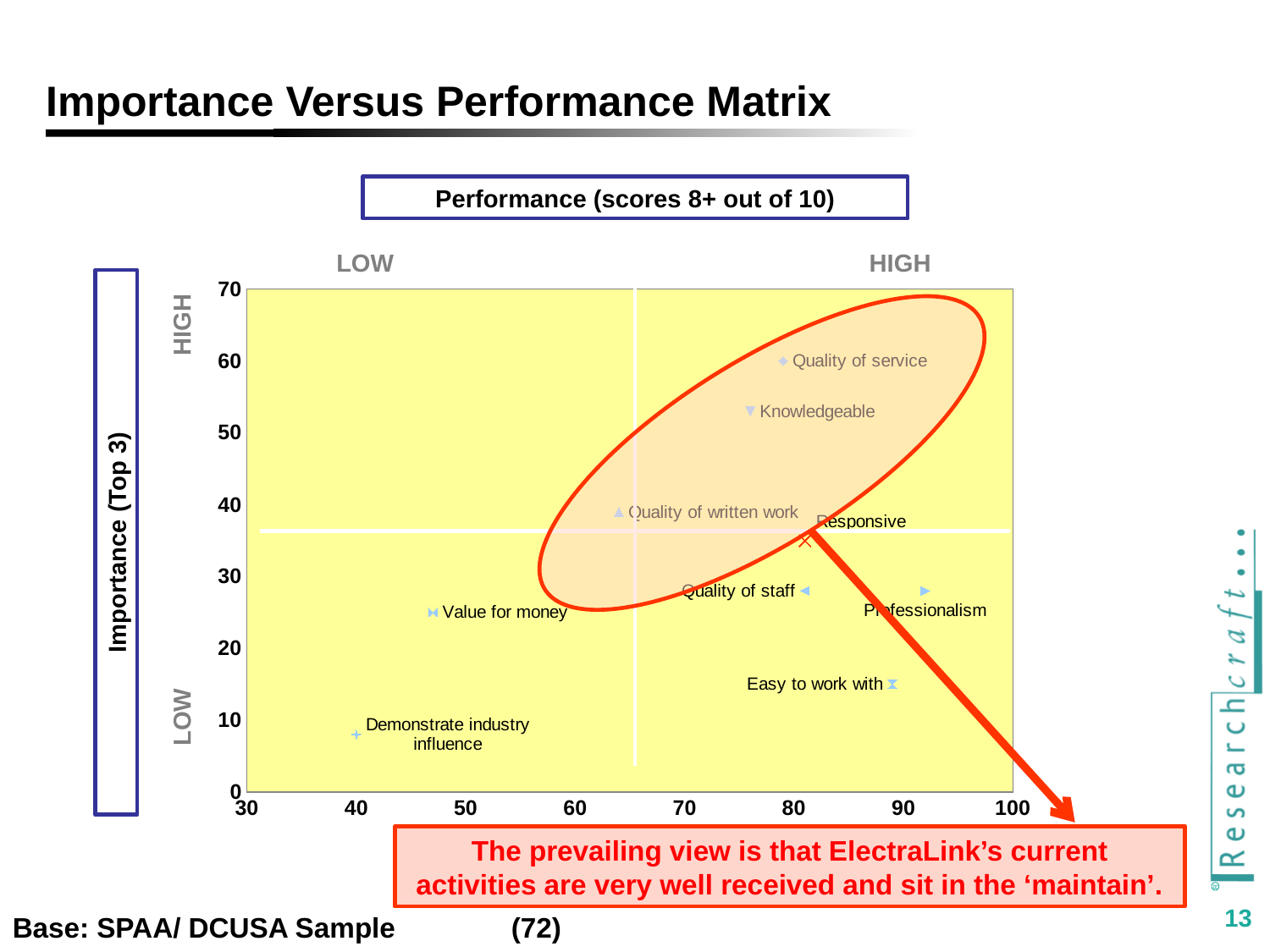
Is the importance value for Demonstrate industry influence greater or less than 20? less How many attributes are plotted as points on the matrix? 9 Is the performance value for Professionalism greater or less than 80? greater What is the title of the chart on the slide? Importance Versus Performance Matrix Which attribute has the lowest importance score on the matrix? Demonstrate industry influence What kind of chart is shown on the slide? Scatter chart Is the importance value for Quality of service greater or less than 50? greater Which attribute has the highest importance score on the matrix? Quality of service Which attribute has the lowest performance score on the matrix? Demonstrate industry influence Which has the higher importance score, Quality of service or Knowledgeable? Quality of service Which has the higher performance score, Professionalism or Value for money? Professionalism